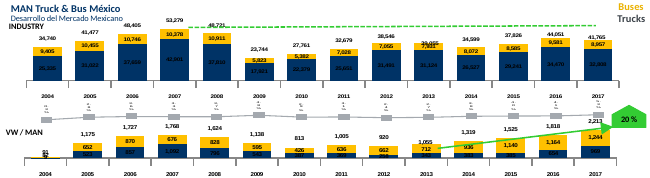
In the VW / MAN chart, what is the total value shown for 2017? 2,213 In the INDUSTRY chart, what is the total value shown for 2007? 53,279 How many years are shown on the x axis of the INDUSTRY chart? 14 In the INDUSTRY chart, which year has the lowest total? 2009 In the VW / MAN chart, what is the Trucks value for 2017? 969 In the INDUSTRY chart, which year has the larger total, 2016 or 2017? 2016 In the VW / MAN chart, which year has the highest total? 2017 In the INDUSTRY chart, what is the difference between the 2007 total and the 2009 total? 29,535 In the INDUSTRY chart, which year has the highest total? 2007 What kind of chart is the INDUSTRY chart? Stacked bar chart How many series does the legend list? 2 In the INDUSTRY chart, what is the total value shown for 2009? 23,744